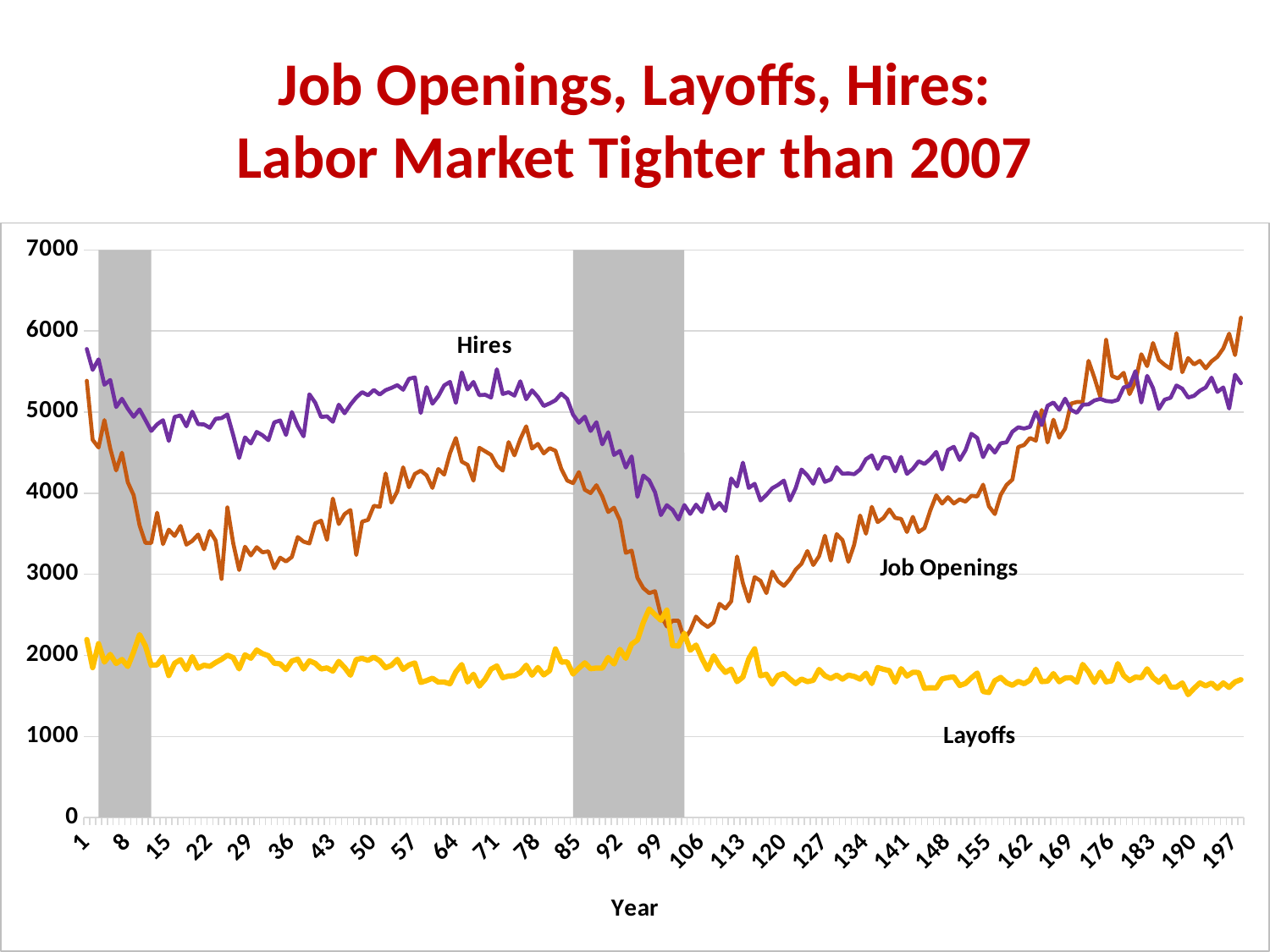
Is the value of Job Openings at year 99 greater or less than 3000? less At year 197, which is higher: Job Openings or Hires? Job Openings Is the value of Job Openings at year 197 greater or less than 5000? greater Is the value of Hires at year 1 greater or less than 5000? greater How many data series are plotted on the chart? 3 What is the label on the x axis of the chart? Year Which series has the lowest values across the whole chart? Layoffs What kind of chart is shown on the slide? Line chart At year 1, which is higher: Hires or Job Openings? Hires Do Job Openings rise or fall between year 106 and year 197? Rise